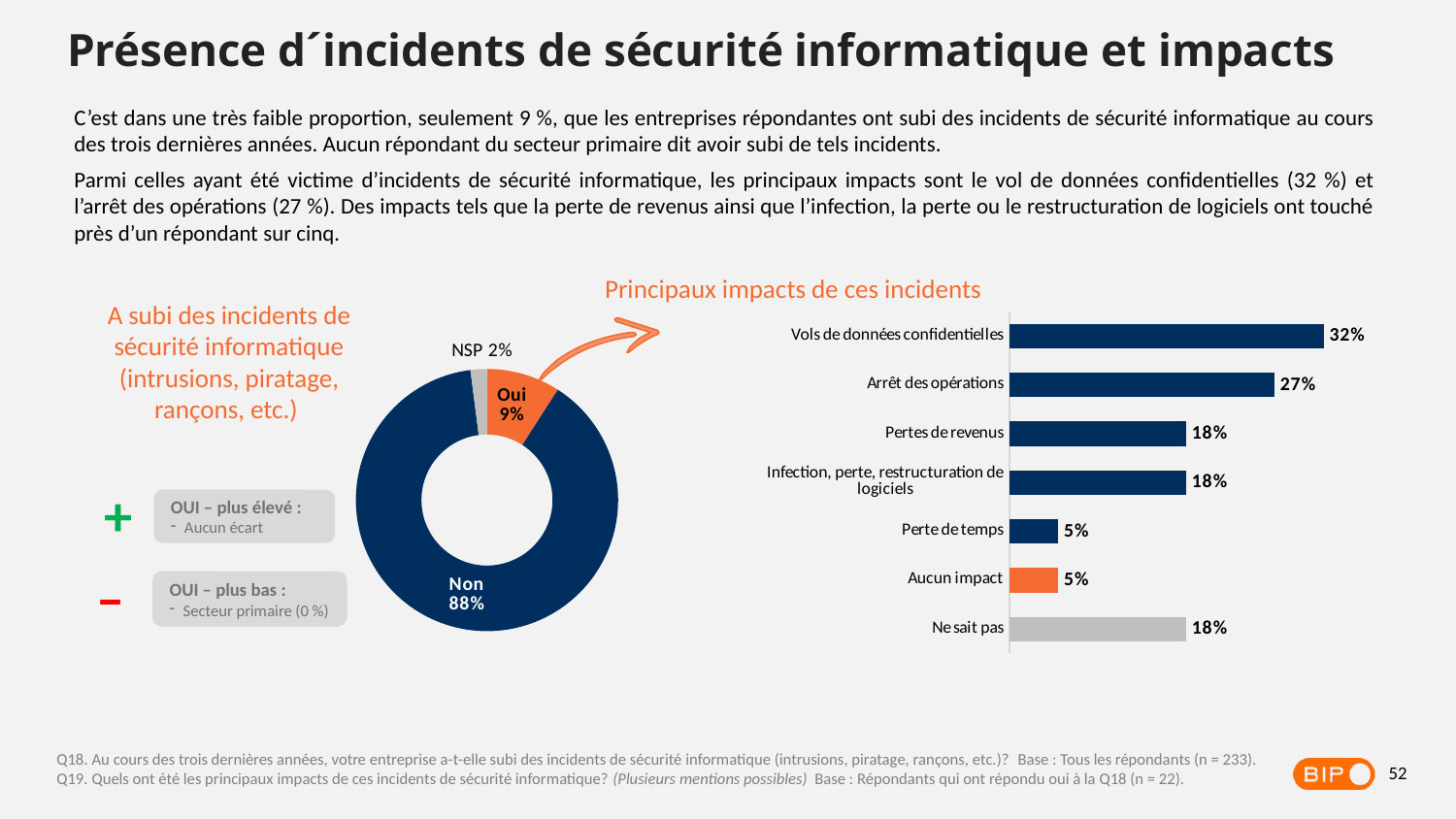
In the chart "Principaux impacts de ces incidents", what is the value for "Perte de temps"? 5% In the donut chart on the left, how many categories are shown? 3 In the chart "Principaux impacts de ces incidents", how many categories are shown? 7 In the donut chart on the left, what share of respondents answered "Non"? 88% In the chart "Principaux impacts de ces incidents", what is the value for "Vols de données confidentielles"? 32% In the donut chart on the left, what share of respondents answered "Oui"? 9% In the donut chart on the left, which category has the largest share? Non What kind of chart is "Principaux impacts de ces incidents"? Bar chart In the chart "Principaux impacts de ces incidents", what is the value for "Arrêt des opérations"? 27% In the donut chart on the left, what share of respondents answered "NSP"? 2% In the chart "Principaux impacts de ces incidents", which category has the highest value? Vols de données confidentielles In the chart "Principaux impacts de ces incidents", what is the difference between "Vols de données confidentielles" and "Arrêt des opérations"? 5%